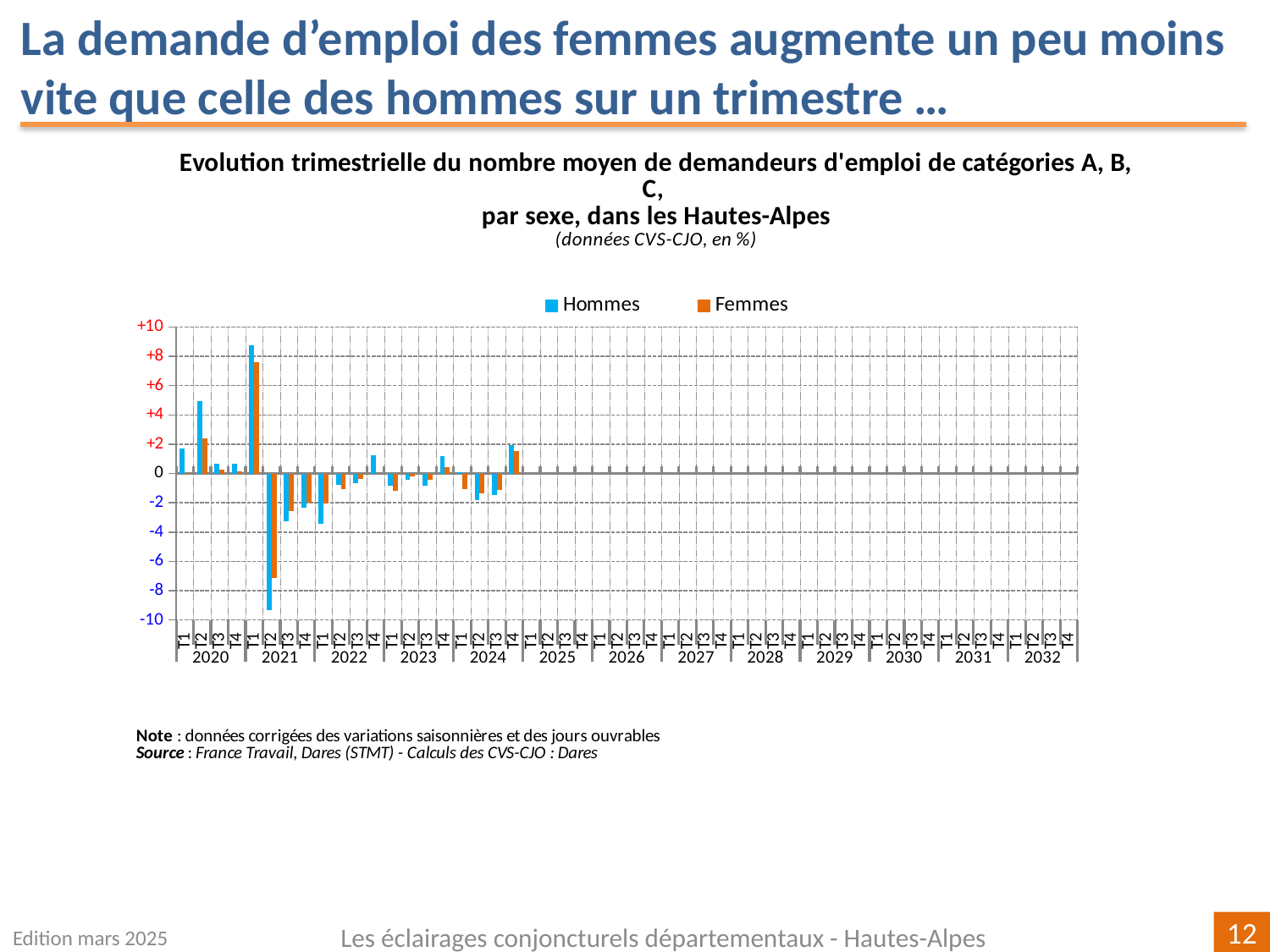
How many series does the legend list? 2 Is the Femmes value for T2 2021 greater or less than -6? less What kind of chart is shown on the slide? Bar chart In which quarter is the Hommes value lowest? T2 2021 Which two series are listed in the legend? Hommes and Femmes In T2 2020, which series has the larger value, Hommes or Femmes? Hommes In which quarter is the Femmes value highest? T1 2021 Is the Hommes value for T2 2021 greater or less than -8? less In which quarter is the Hommes value highest? T1 2021 Is the Hommes value for T1 2021 greater or less than +8? greater In which quarter is the Femmes value lowest? T2 2021 What colour are the bars for the Hommes series? Blue